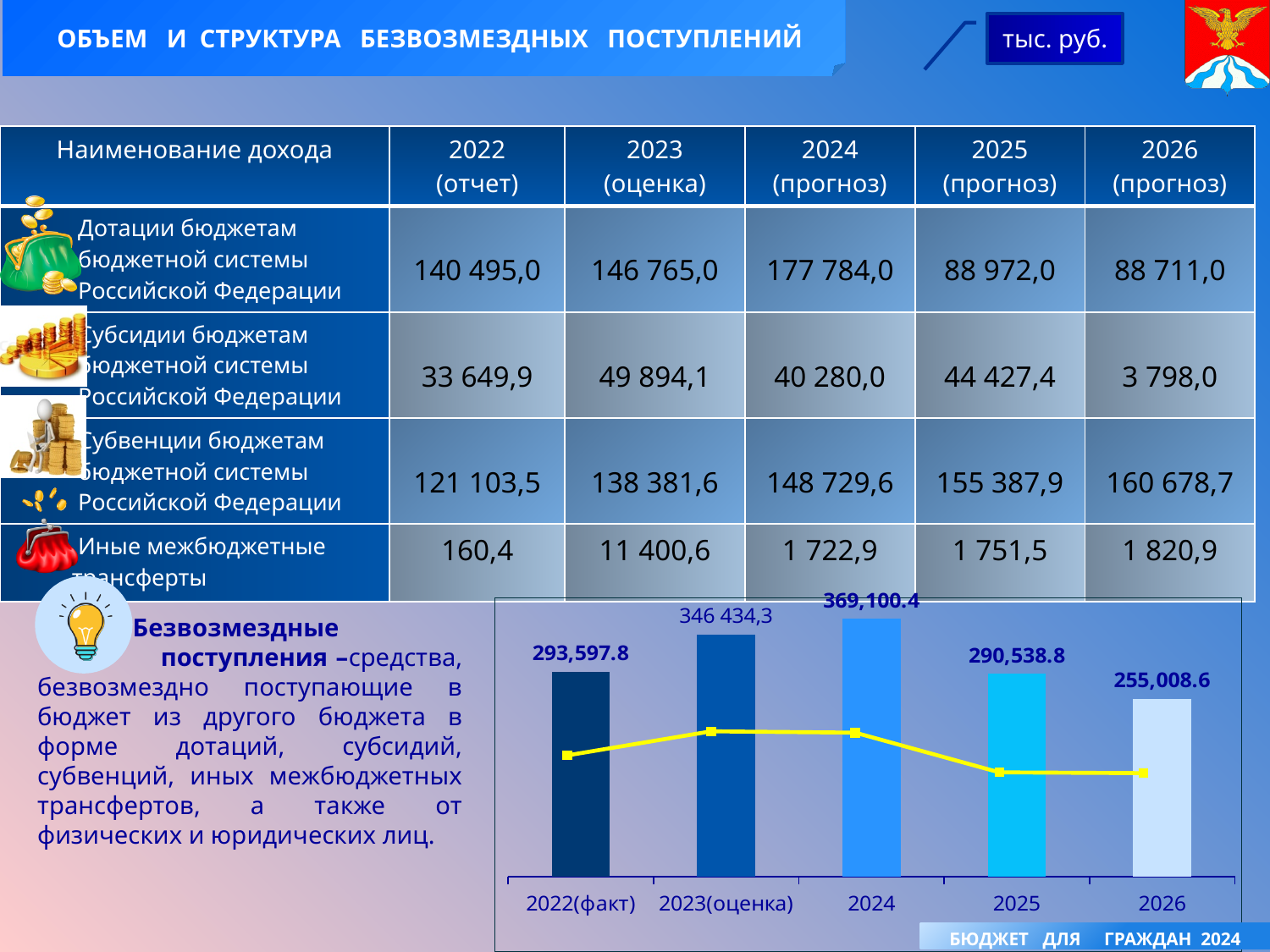
What is the value shown for 2025 in the bar chart? 290,538.8 Do the bar values rise or fall from 2024 to 2026? fall What is the value shown for 2024 in the bar chart? 369,100.4 What is the value shown for 2023(оценка) in the bar chart? 346 434,3 What is the difference between the 2024 value and the 2026 value in the bar chart? 114,091.8 How many bars are plotted in the chart? 5 What is the difference between the 2022(факт) value and the 2026 value in the bar chart? 38,589.2 What is the value shown for 2022(факт) in the bar chart? 293,597.8 Which year has the highest bar in the chart? 2024 Which year has the lowest bar in the chart? 2026 Which is larger in the bar chart, the value for 2023(оценка) or the value for 2025? 2023(оценка) What is the value shown for 2026 in the bar chart? 255,008.6